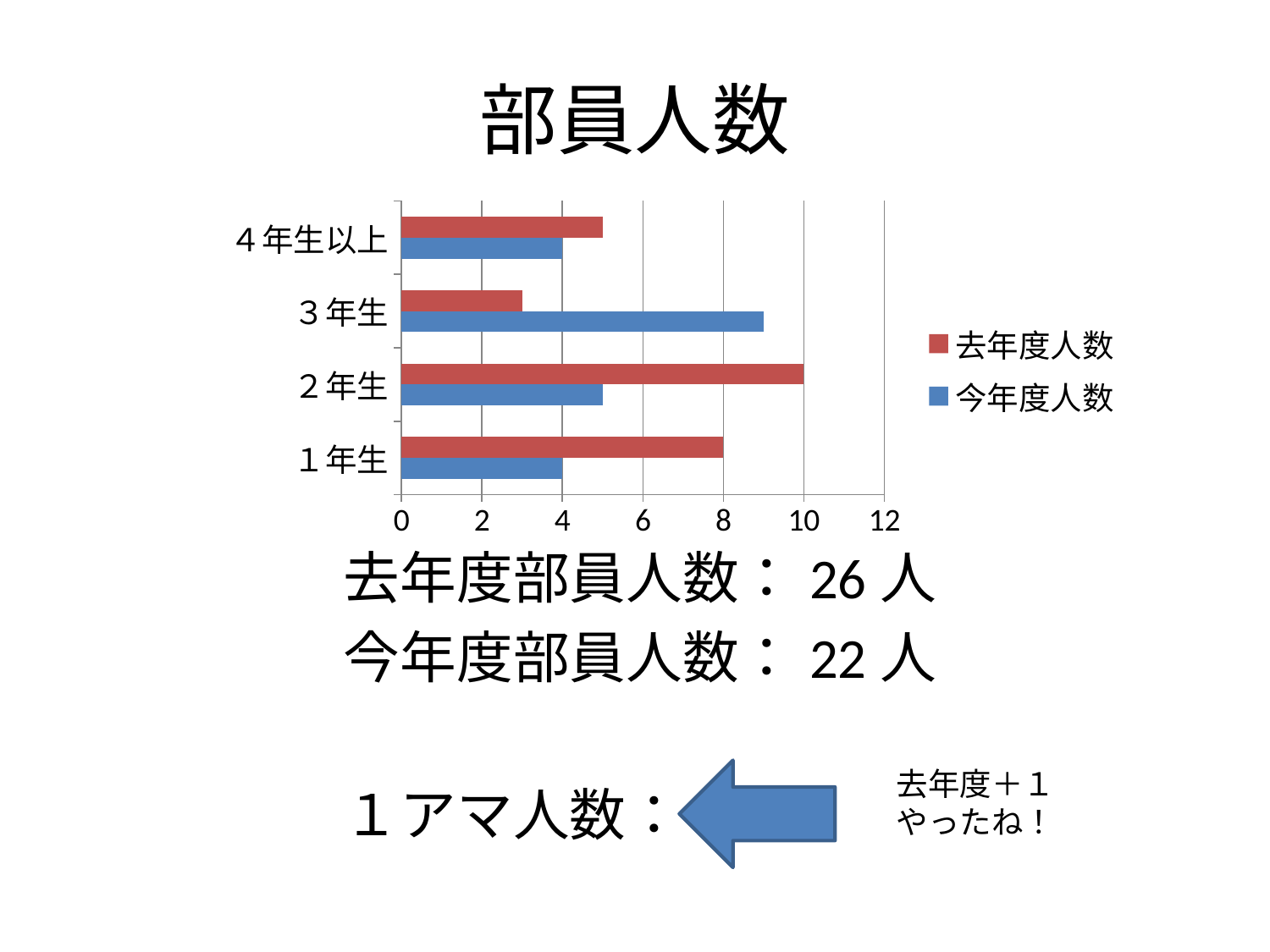
For 2年生, which series has the larger value, 去年度人数 or 今年度人数? 去年度人数 What is the 今年度人数 value for 1年生? 4 What is the 去年度人数 value for 1年生? 8 Which category has the highest 去年度人数 value? 2年生 What is the difference between the 去年度人数 and 今年度人数 values for 1年生? 4 How many categories are shown on the chart's vertical axis? 4 Is the 今年度人数 value for 3年生 greater or less than 8? greater What is the 去年度人数 value for 2年生? 10 How many series does the chart legend list? 2 Which category has the highest 今年度人数 value? 3年生 Which category has the lowest 去年度人数 value? 3年生 What kind of chart is shown on the slide? bar chart